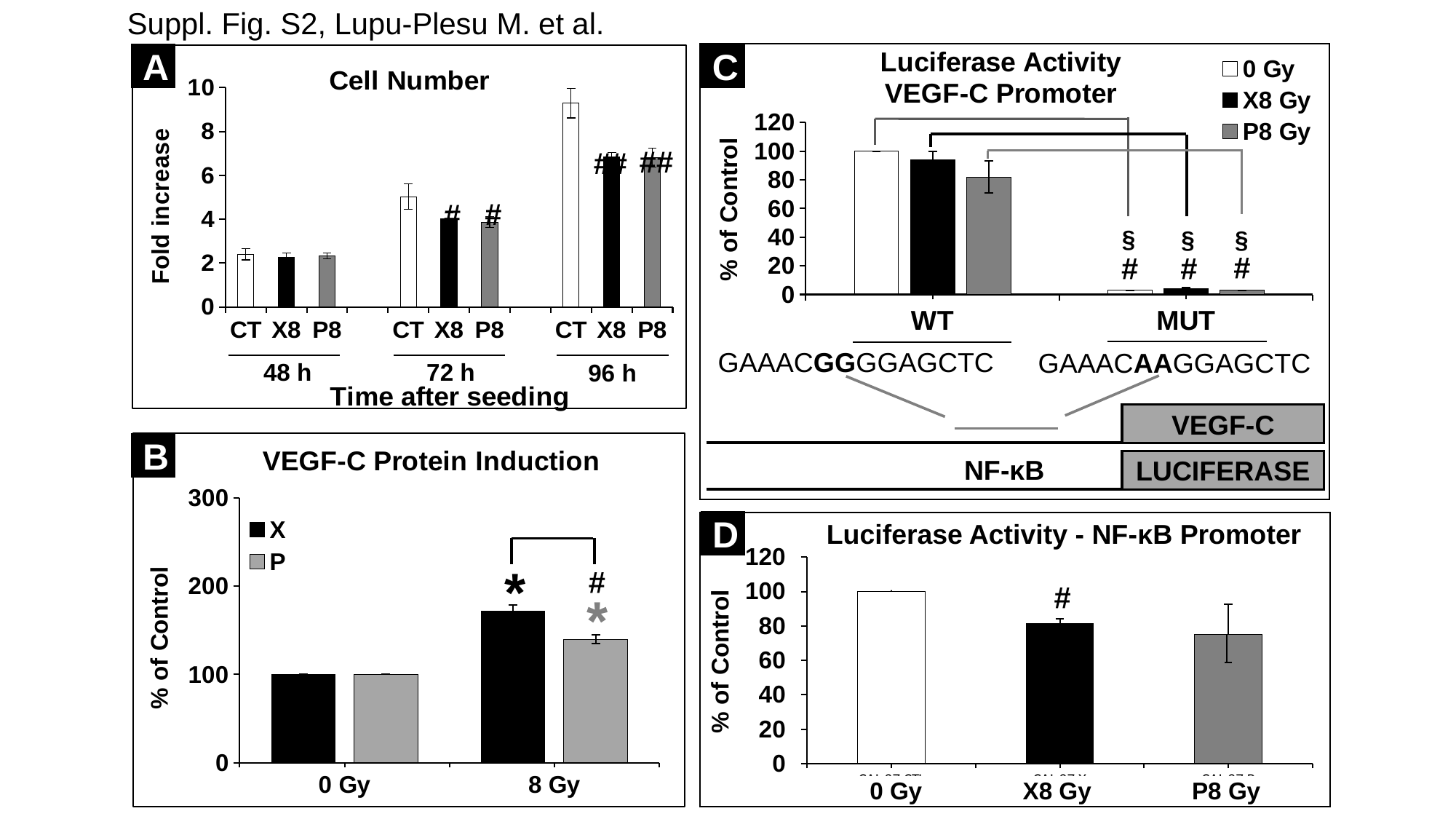
In the Luciferase Activity VEGF-C Promoter chart (panel C), which is larger for X8 Gy, WT or MUT? WT In the VEGF-C Protein Induction chart (panel B), which is larger at 8 Gy, X or P? X In the Luciferase Activity VEGF-C Promoter chart (panel C), is the value for X8 Gy in MUT greater or less than 20? less In the Luciferase Activity VEGF-C Promoter chart (panel C), how many series does the legend list? 3 What kind of chart is the Luciferase Activity - NF-κB Promoter chart (panel D)? bar chart In the VEGF-C Protein Induction chart (panel B), how many series does the legend list? 2 In the VEGF-C Protein Induction chart (panel B), is the value for X at 8 Gy greater or less than 200? less In the Cell Number chart (panel A), does the CT value rise or fall from 48 h to 96 h? rise In the Luciferase Activity - NF-κB Promoter chart (panel D), which category has the highest value? 0 Gy In the Cell Number chart (panel A), is the value for CT at 96 h greater or less than 8? greater In the Cell Number chart (panel A), how many time points are shown on the x axis? 3 In the Cell Number chart (panel A), which bar is the highest? CT at 96 h